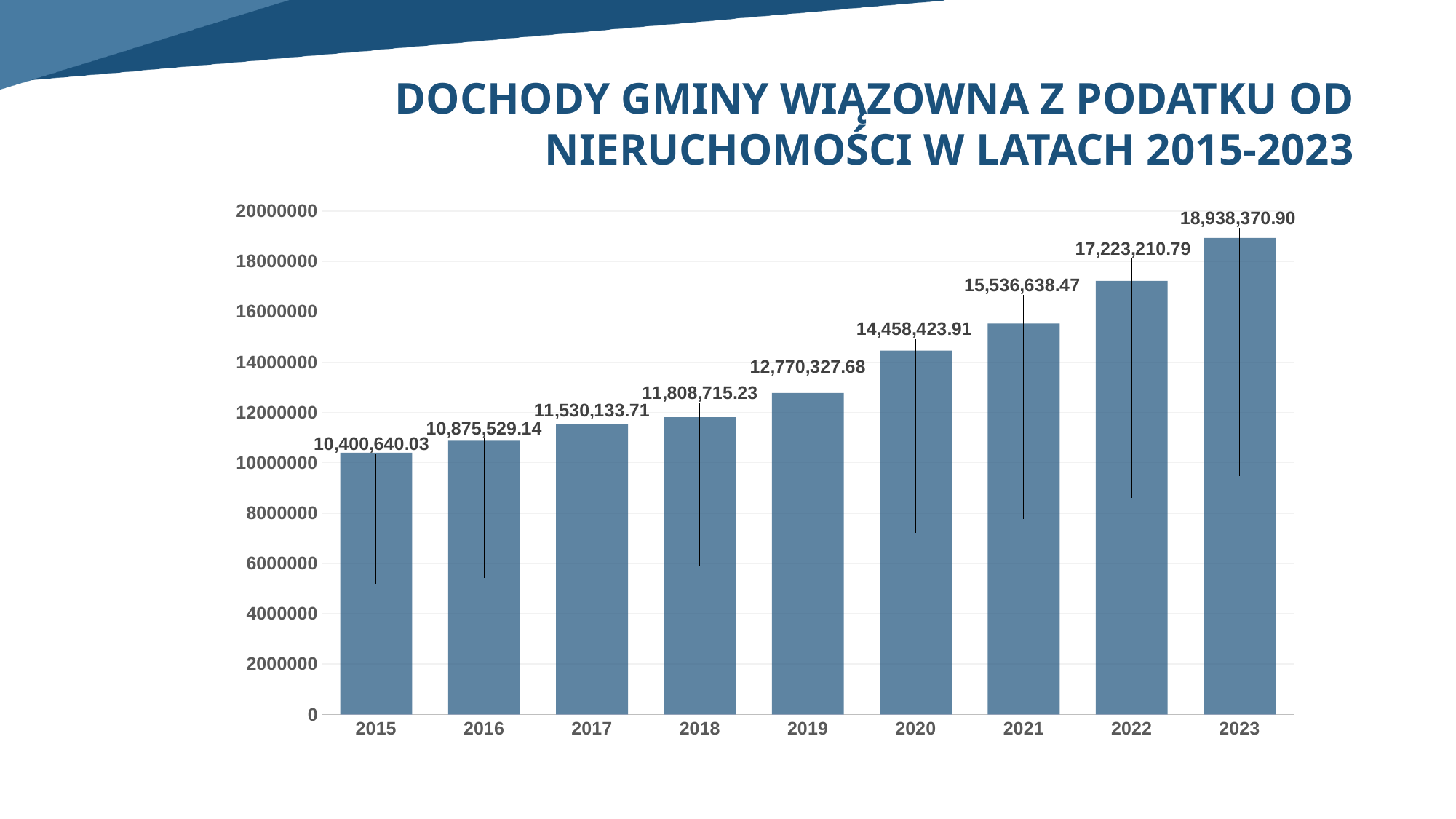
Do the values rise or fall from 2015 to 2023? rise Is the value for 2020 greater or less than 14000000? greater What is the difference between the values for 2023 and 2015? 8,537,730.87 Which year has the highest value? 2023 What type of chart is shown on the slide? bar chart How many years are shown on the x axis? 9 Which year has the lowest value? 2015 What is the difference between the values for 2020 and 2019? 1,688,096.23 What is the value for 2015? 10,400,640.03 Which is larger, the value for 2018 or the value for 2021? 2021 What is the value for 2019? 12,770,327.68 What is the value for 2022? 17,223,210.79